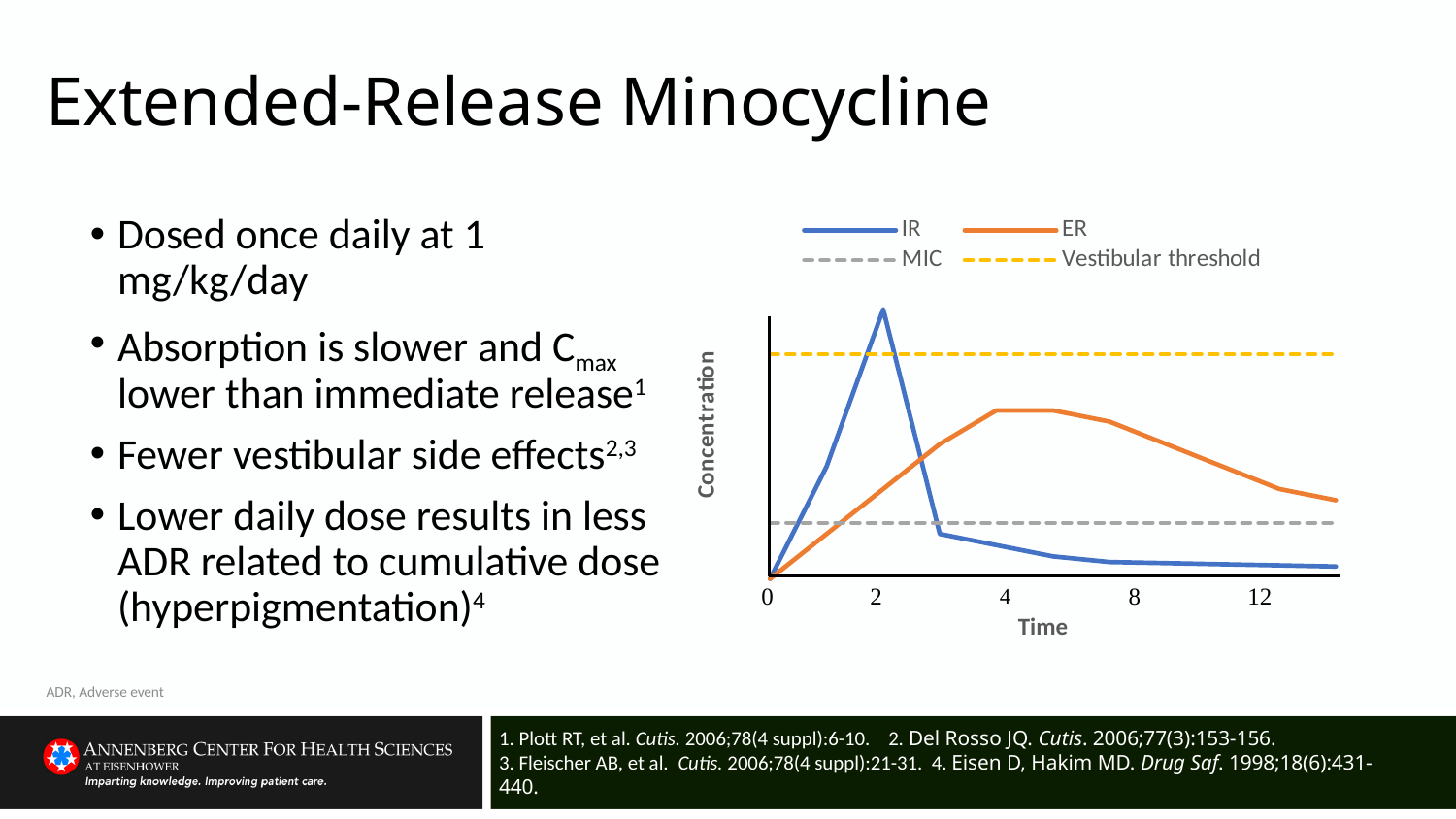
Does the ER concentration rise or fall between time 0 and time 4? rise Which series peaks earlier in time, IR or ER? IR What is the label of the chart's y axis? Concentration At time 8, which series has the higher concentration, IR or ER? ER What kind of chart is shown on the slide? line chart Which series is drawn as a dashed grey line? MIC Which series reaches the higher peak concentration, IR or ER? IR What are the four series listed in the chart legend? IR, ER, MIC, Vestibular threshold Does the IR concentration rise or fall between time 2 and time 4? fall How many series does the chart legend list? 4 Does the ER concentration rise or fall between time 8 and time 12? fall